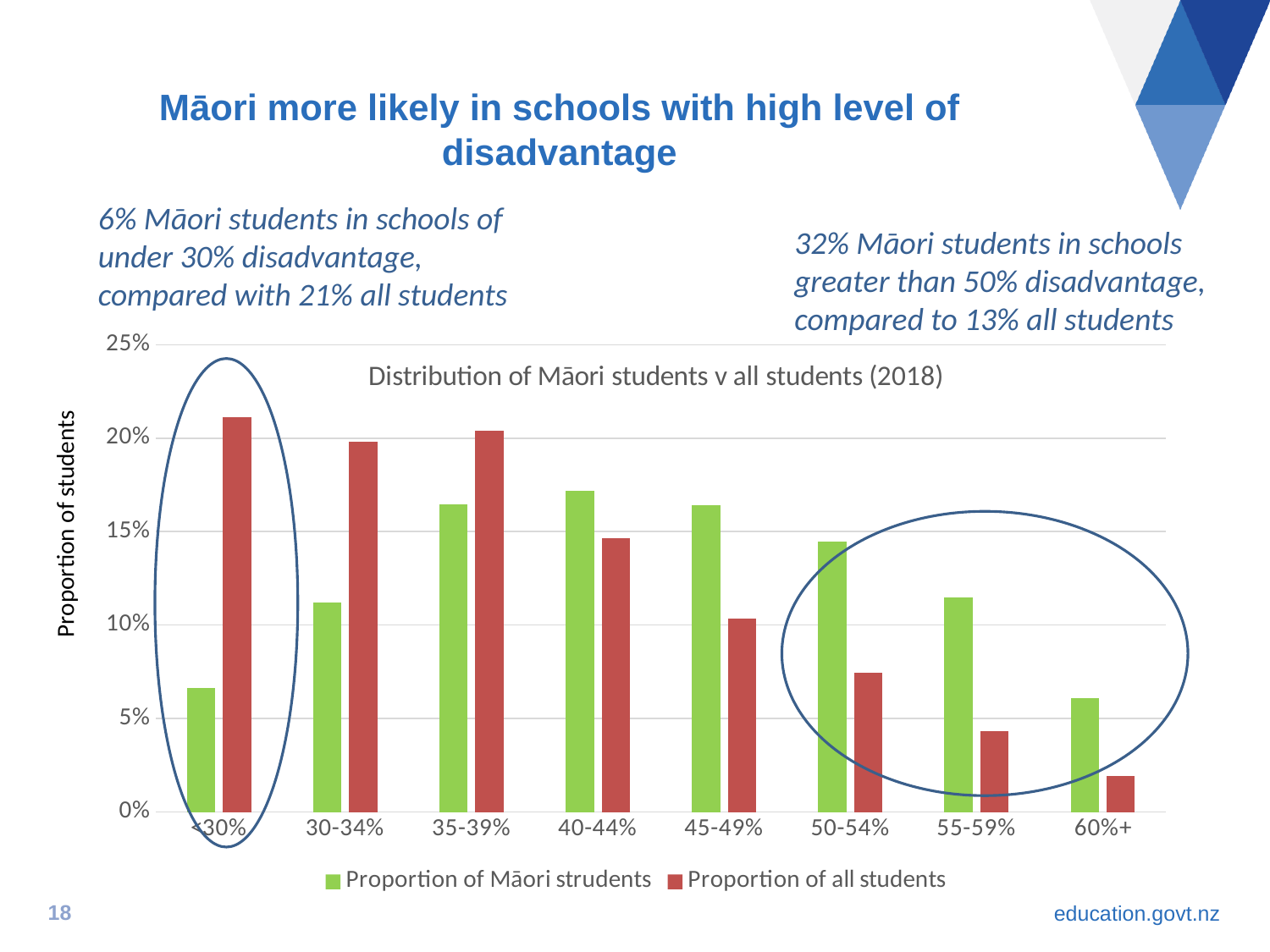
Does the Proportion of all students series rise or fall from the 35-39% category to the 60%+ category? fall What is the title of the chart? Distribution of Māori students v all students (2018) Is the value for Proportion of Māori strudents in the 55-59% category greater or less than 10%? greater How many disadvantage categories are shown on the x axis? 8 What kind of chart is shown on the slide? bar chart Is the value for Proportion of all students in the <30% category greater or less than 20%? greater How many series does the legend list? 2 Which category has the lowest value for Proportion of all students? 60%+ In the <30% category, which series has the larger value: Proportion of Māori strudents or Proportion of all students? Proportion of all students Is the value for Proportion of all students in the 55-59% category greater or less than 5%? less In the 55-59% category, which series has the larger value: Proportion of Māori strudents or Proportion of all students? Proportion of Māori strudents